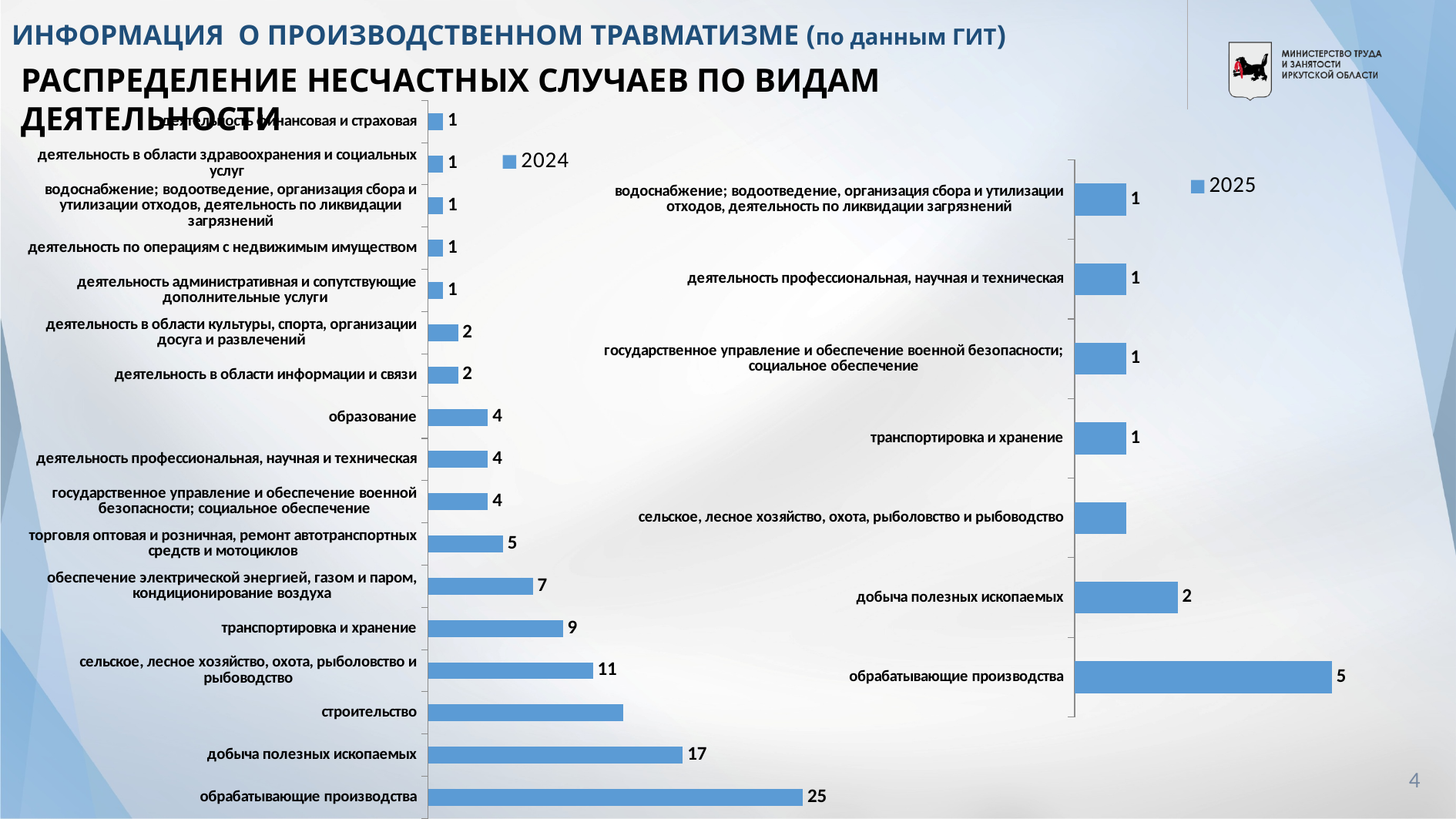
In the 2025 chart (right), what is the value for добыча полезных ископаемых? 2 In the 2025 chart (right), what is the value for обрабатывающие производства? 5 What legend entry is shown for the chart on the right? 2025 In the 2024 chart (left), what is the value for добыча полезных ископаемых? 17 In the 2024 chart (left), which is larger: сельское, лесное хозяйство, охота, рыболовство и рыбоводство or транспортировка и хранение? сельское, лесное хозяйство, охота, рыболовство и рыбоводство What type of chart is the 2024 chart (left)? bar chart In the 2024 chart (left), what is the value for обрабатывающие производства? 25 In the 2024 chart (left), what is the value for транспортировка и хранение? 9 In the 2024 chart (left), which category has the highest value? обрабатывающие производства In the 2024 chart (left), what is the difference between обрабатывающие производства and добыча полезных ископаемых? 8 In the 2025 chart (right), which category has the highest value? обрабатывающие производства How many categories are shown in the 2025 chart (right)? 7